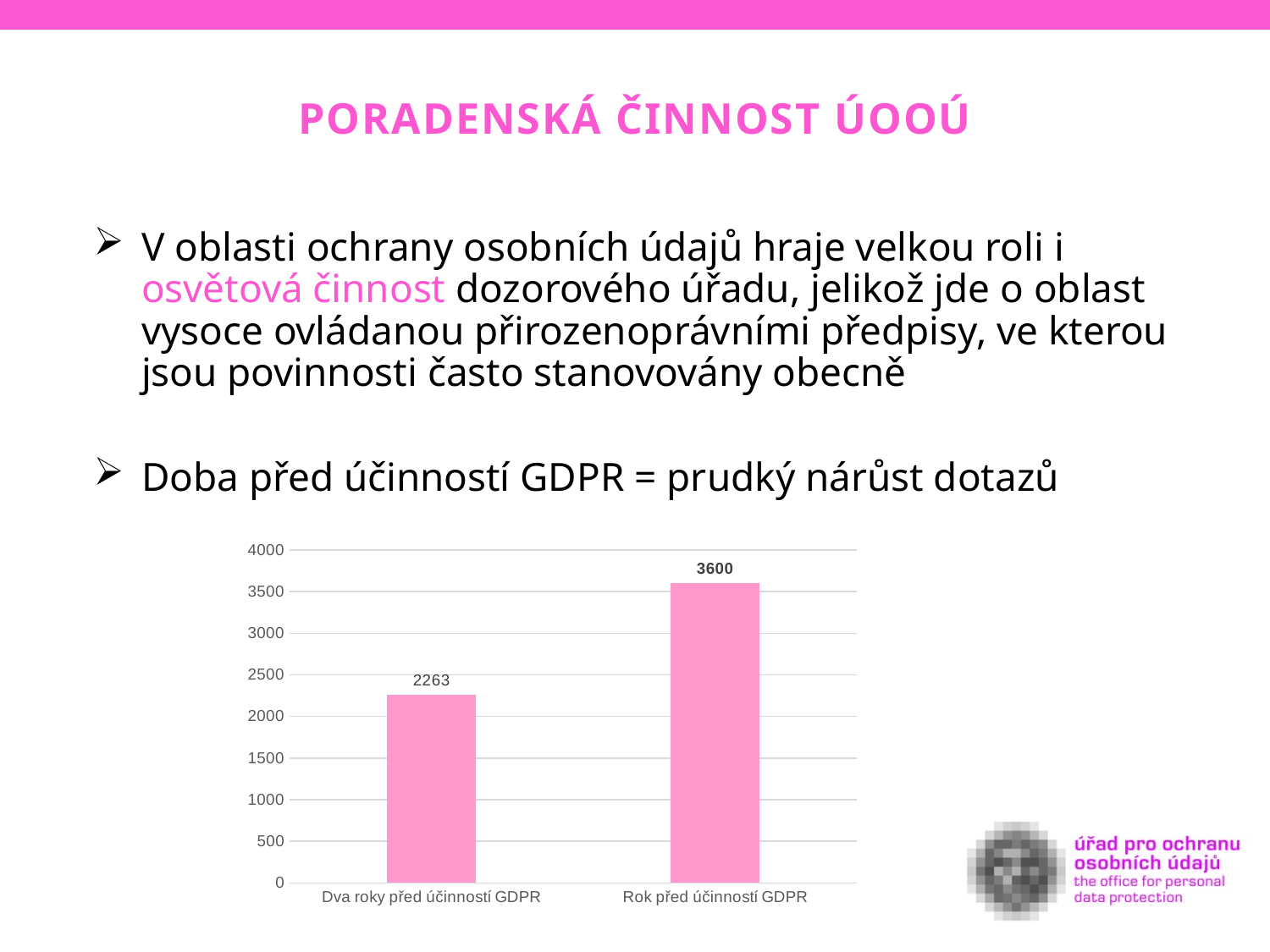
Is the value for "Rok před účinností GDPR" greater or less than 3500? greater What kind of chart is shown on the slide? bar chart Do the values rise or fall from left to right along the x axis? rise What colour are the bars in the chart? pink What is the value for "Rok před účinností GDPR"? 3600 What is the difference between the values for "Rok před účinností GDPR" and "Dva roky před účinností GDPR"? 1337 What is the value for "Dva roky před účinností GDPR"? 2263 Which category has the lowest value? Dva roky před účinností GDPR Is the value for "Dva roky před účinností GDPR" greater or less than 2500? less Which category has the highest value? Rok před účinností GDPR Which is larger, the value for "Dva roky před účinností GDPR" or the value for "Rok před účinností GDPR"? Rok před účinností GDPR How many categories are shown on the chart? 2